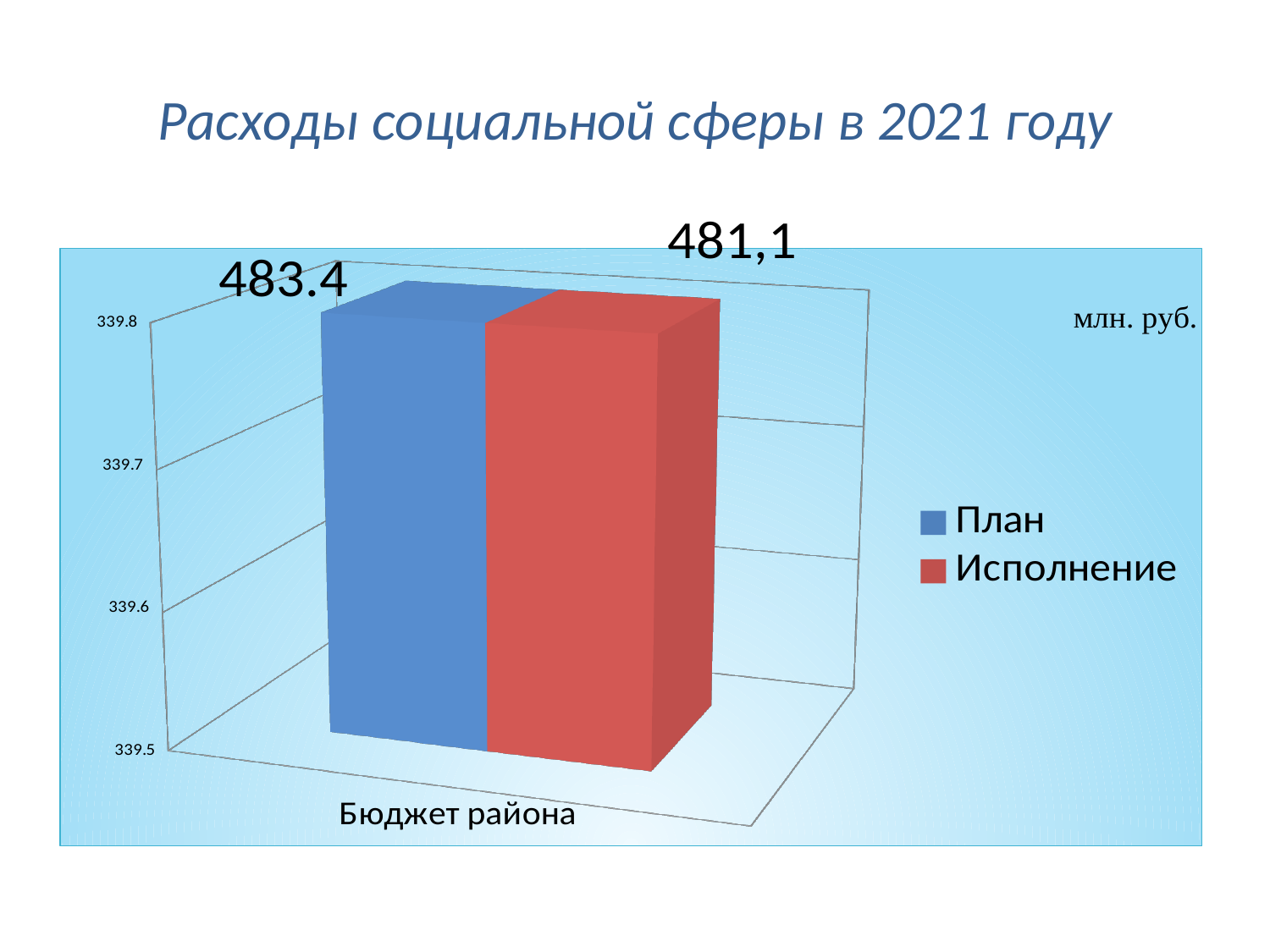
What is the value for План (Plan) in the chart? 483.4 What is the title of the slide's chart? Расходы социальной сферы в 2021 году How many categories are shown on the x axis of the chart? 1 What is the name of the category shown on the x axis? Бюджет района Which series shows the lowest value in the chart? Исполнение Which series has the higher value, План or Исполнение? План What kind of chart is shown on the slide? Bar chart By how much does the План value exceed the Исполнение value? 2.3 What unit of measurement is indicated on the chart? млн. руб. How many series does the legend list? 2 What is the value for Исполнение (Execution) in the chart? 481,1